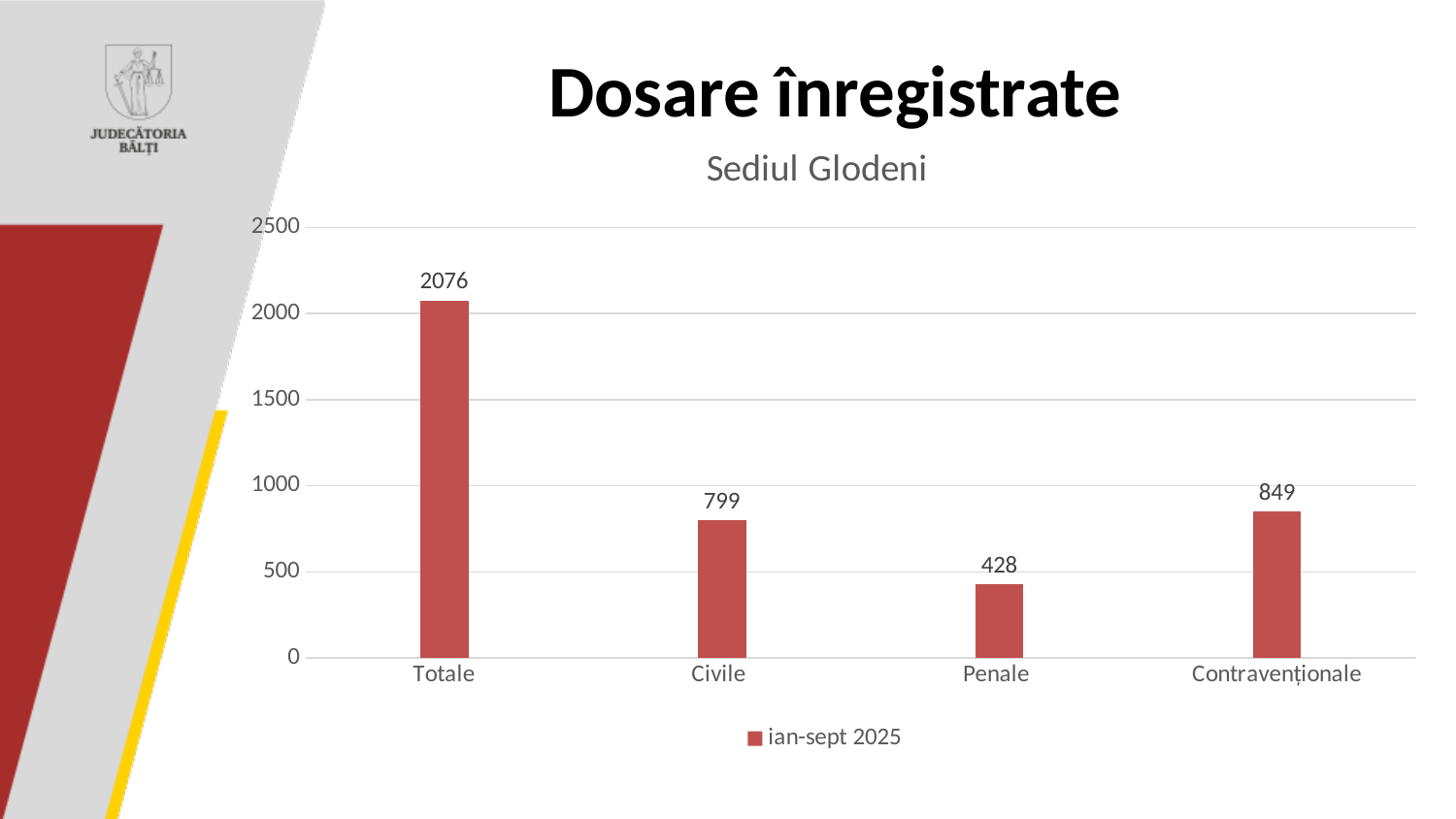
How many categories are shown on the x axis? 4 What series does the legend list? ian-sept 2025 What is the value for Contravenționale? 849 What is the value for Civile? 799 Which is larger, the value for Civile or the value for Penale? Civile What is the value for Penale? 428 What is the value for Totale? 2076 What kind of chart is shown on the slide? bar chart Which category has the lowest value? Penale Is the value for Contravenționale greater or less than 1000? less What is the difference between the values for Contravenționale and Civile? 50 Which category has the highest value? Totale